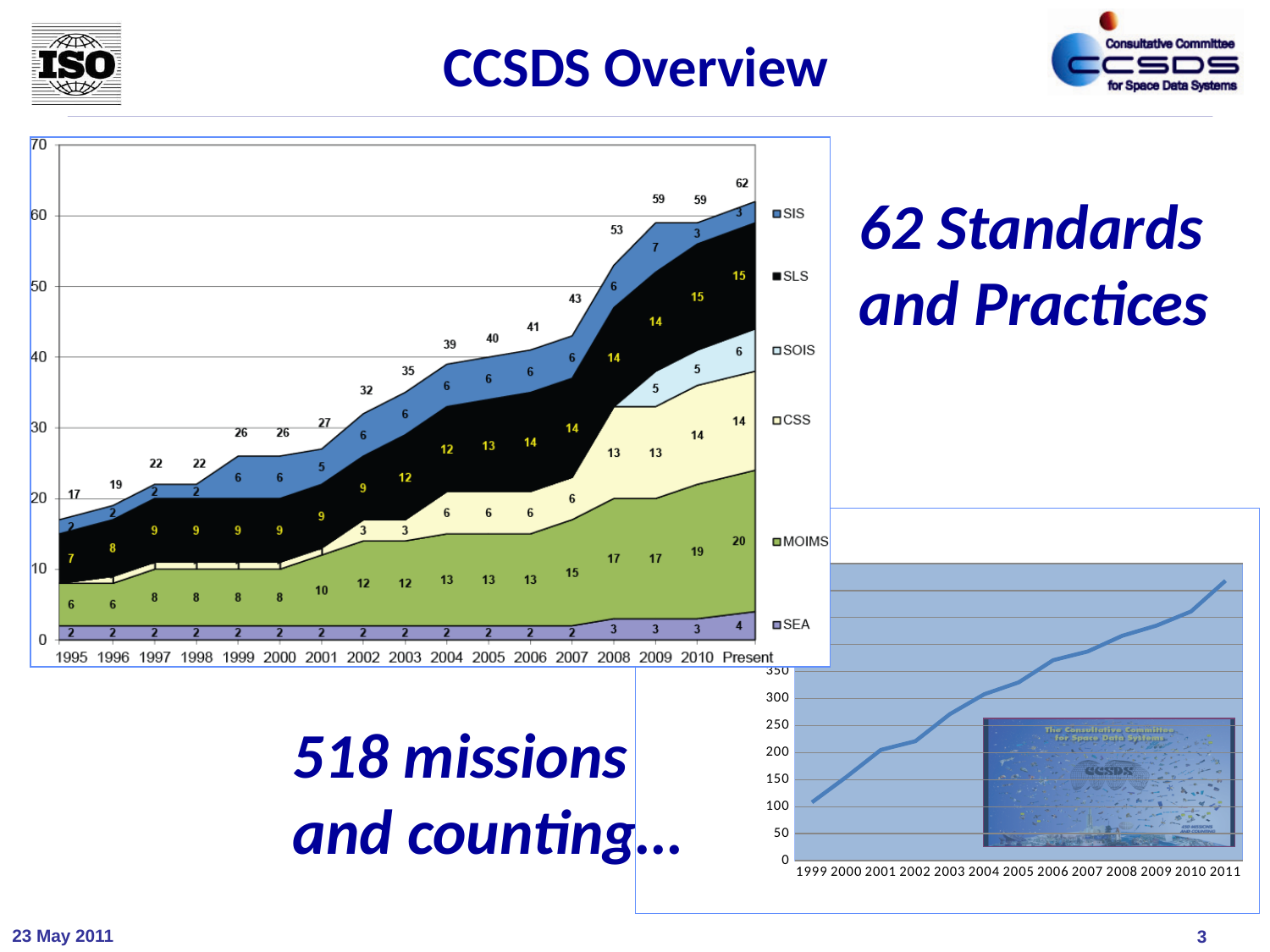
In the stacked area chart on the left, which year has the highest total? Present In the stacked area chart on the left, which year has the lowest total? 1995 How many series does the legend of the stacked area chart on the left list? 6 In the line chart in the bottom right, do the values rise or fall from 1999 to 2011? Rise In the stacked area chart on the left, what is the difference between the totals for 2008 and 2007? 10 In the stacked area chart on the left, what is the total number of standards shown for 2008? 53 In the stacked area chart on the left, what is the SEA value for 2008? 3 In the stacked area chart on the left, what is the MOIMS value for 2010? 19 In the stacked area chart on the left, what is the SLS value at Present? 15 In the line chart in the bottom right, is the value for 2001 greater or less than 150? greater What kind of chart is the chart in the bottom right of the slide? Line chart In the stacked area chart on the left, which is larger, the CSS value for 2009 or the SOIS value for 2009? CSS